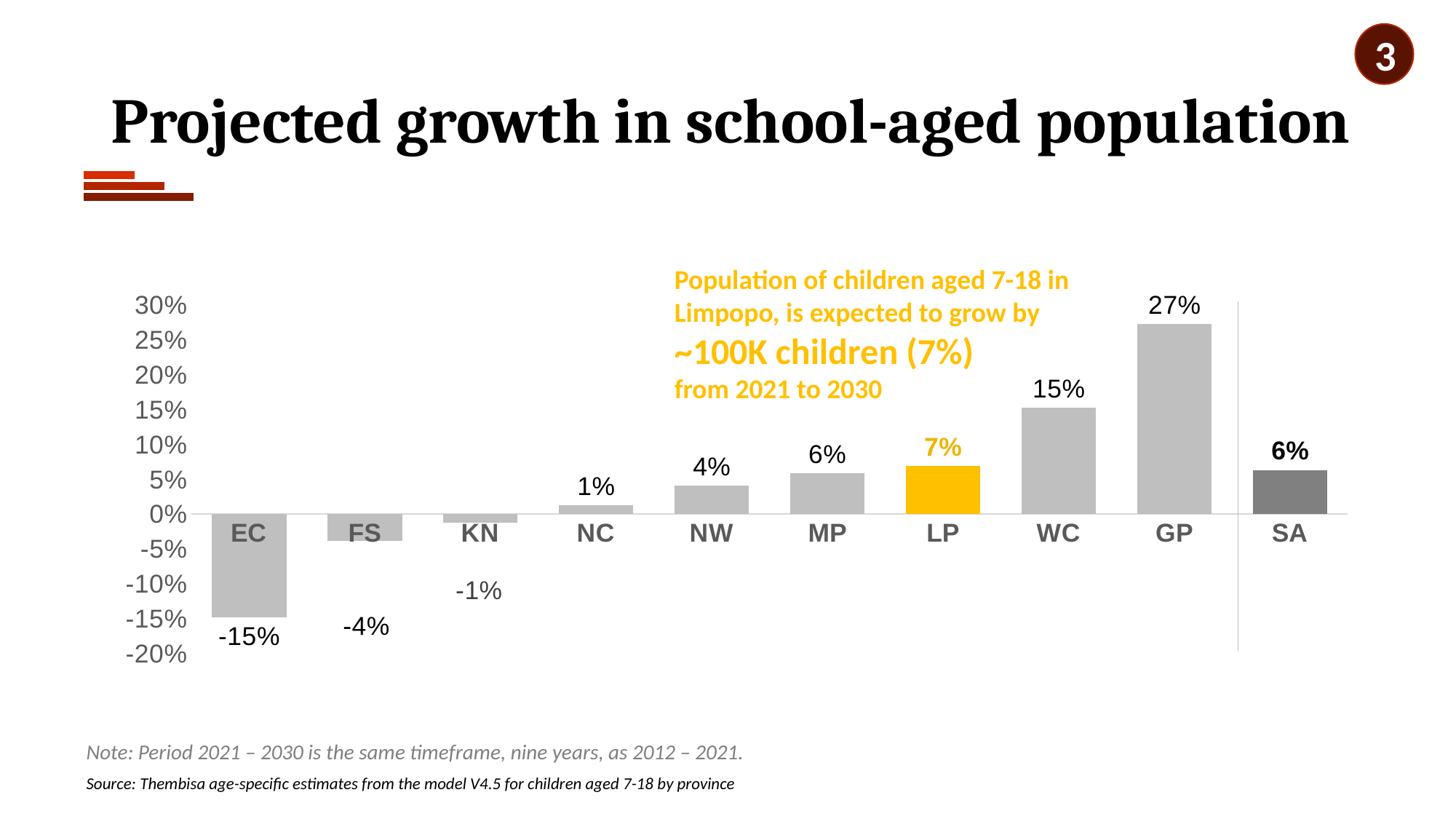
Which has a larger projected growth, MP or NW? MP Which province has the highest projected growth? GP What is the projected growth value for GP? 27% What is the difference between the projected growth for GP and WC? 12% What is the projected growth value for EC? -15% What is the projected growth value for SA? 6% Which bar is highlighted in yellow? LP What is the projected growth value for LP? 7% What is the difference between the projected growth for LP and SA? 1% What kind of chart is shown on the slide? Bar chart How many categories are shown on the x axis? 10 Which province has the lowest projected growth? EC